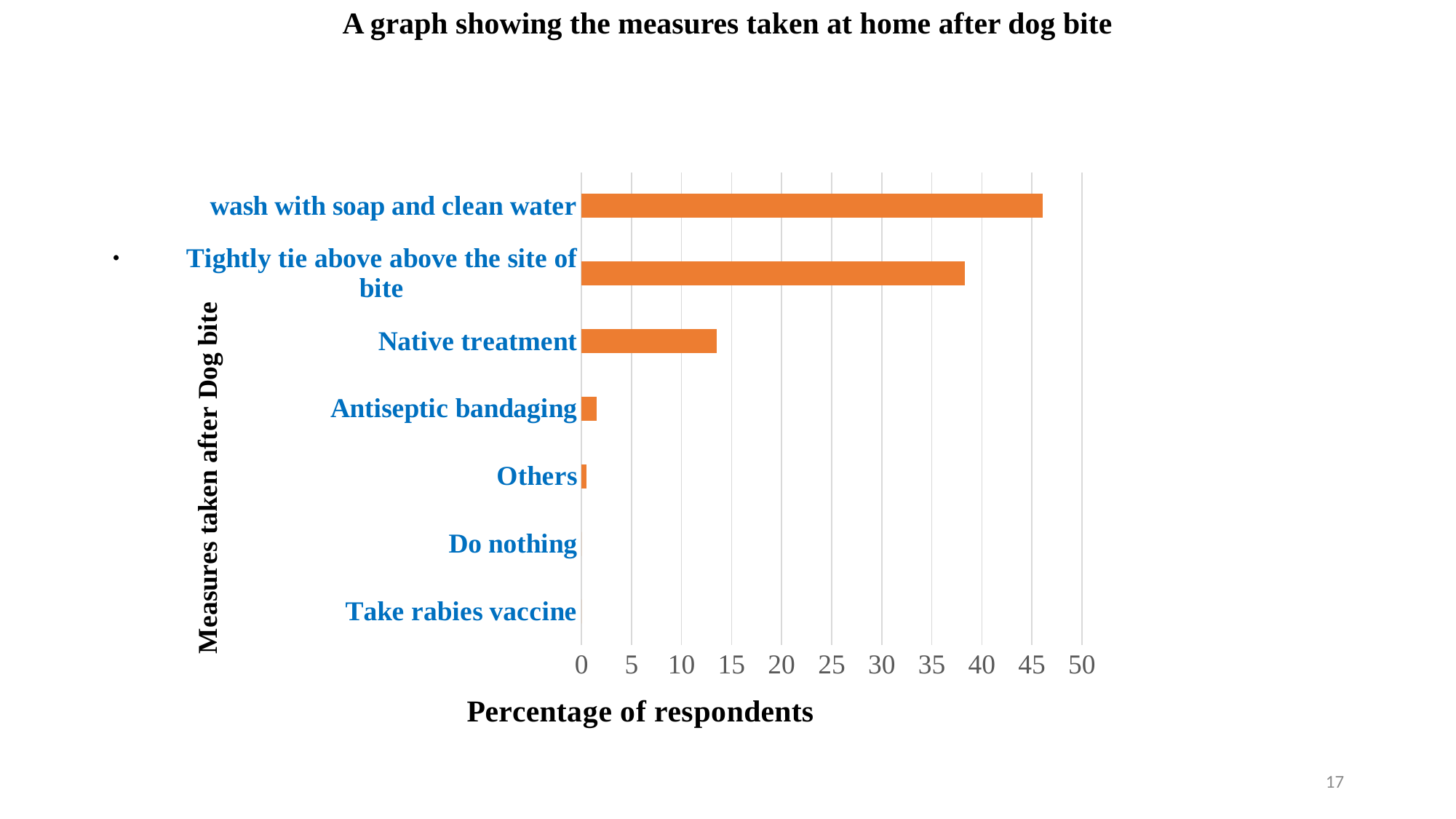
Is the value for 'Tightly tie above above the site of bite' greater or less than 35? greater Which measure has the highest percentage of respondents? wash with soap and clean water Which is larger: the value for 'Native treatment' or for 'Antiseptic bandaging'? Native treatment What is the title of the horizontal axis of the chart? Percentage of respondents Is the value for 'wash with soap and clean water' greater or less than 40? greater Is the value for 'Tightly tie above above the site of bite' greater or less than 40? less How many measures (categories) are listed on the chart? 7 What kind of chart is shown on the slide? bar chart Which is larger: the value for 'wash with soap and clean water' or for 'Tightly tie above above the site of bite'? wash with soap and clean water